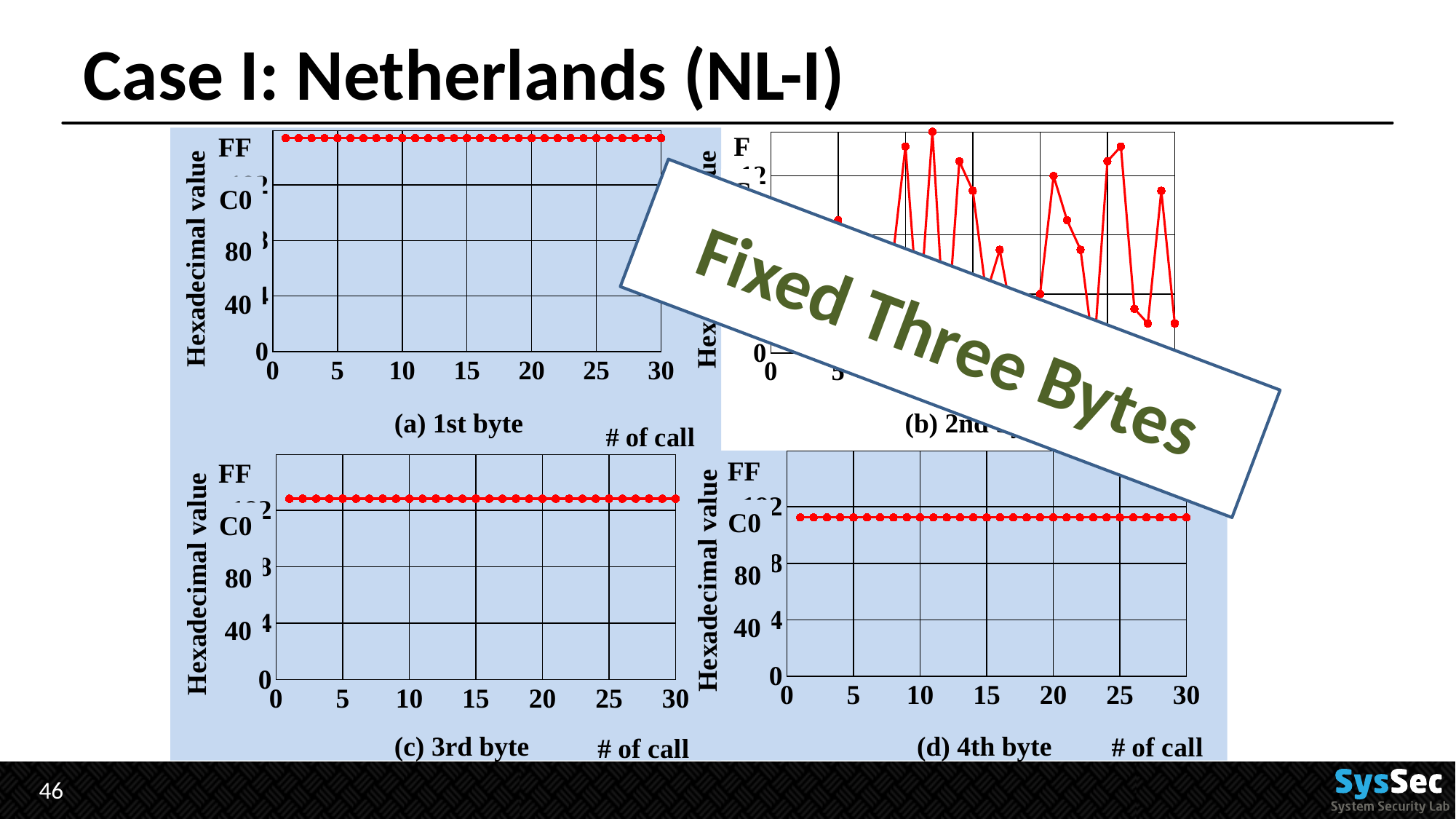
What kind of chart is chart (a) 1st byte? line chart In chart (c) 3rd byte, is the value at call 20 greater or less than 80? greater In chart (a) 1st byte, do the values rise, fall, or stay constant as the number of calls increases? stay constant How many charts are shown on the slide? 4 What is the x-axis label of chart (d) 4th byte? # of call In chart (d) 4th byte, is the value at call 15 greater or less than 80? greater In chart (c) 3rd byte, do the values rise, fall, or stay constant along the x axis? stay constant In chart (a) 1st byte, is the value at call 10 greater or less than C0? greater Which of the four charts shows values that fluctuate rather than stay constant? (b) 2nd byte In chart (d) 4th byte, do the values rise, fall, or stay constant along the x axis? stay constant What is the highest tick label on the y axis of chart (c) 3rd byte? FF